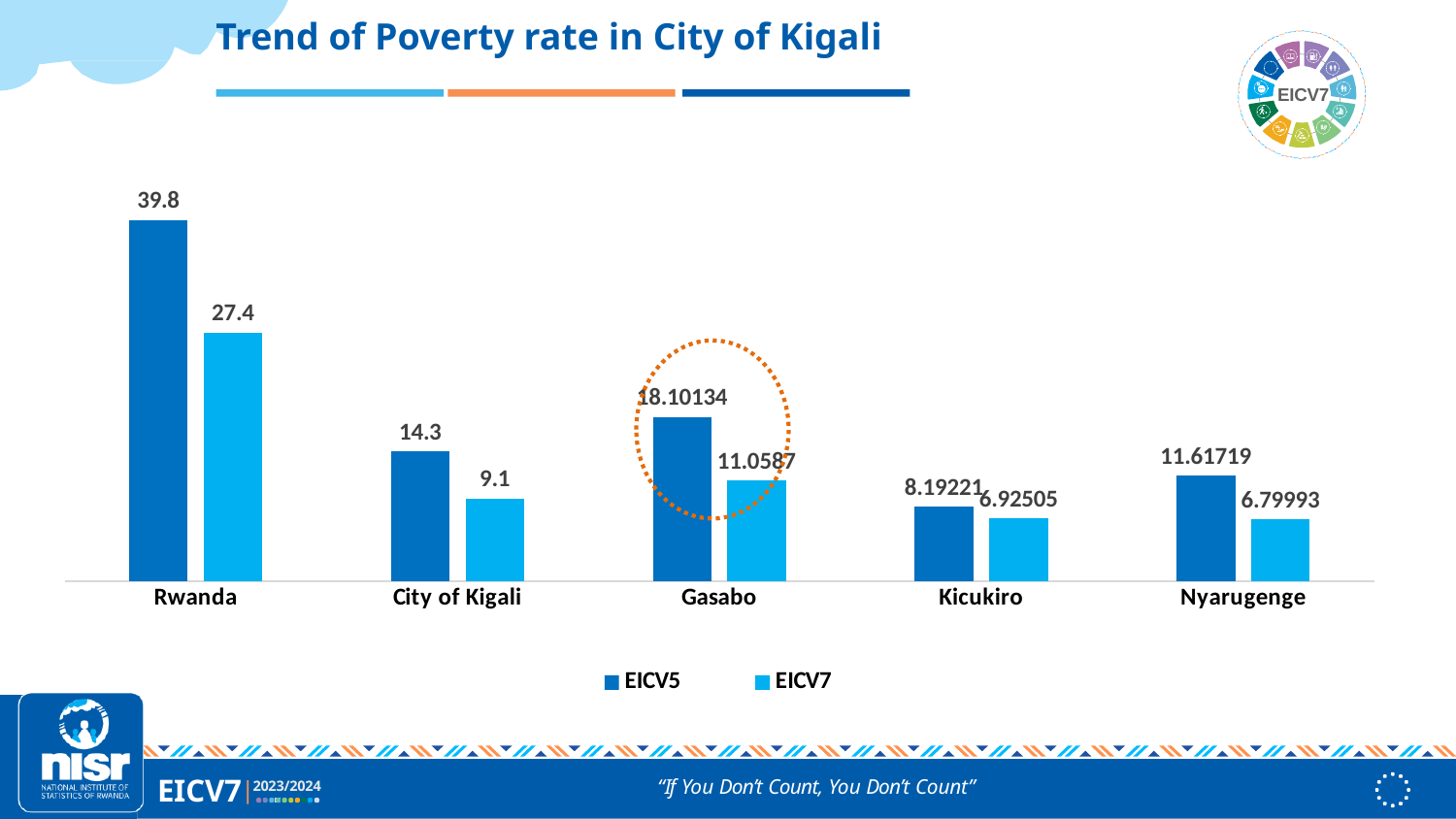
What is the EICV7 poverty rate for City of Kigali? 9.1 Which is larger, the EICV5 value for Gasabo or the EICV5 value for Nyarugenge? Gasabo Which category has the lowest EICV5 value? Kicukiro How many series does the legend list? 2 How many categories are shown on the x axis? 5 What is the EICV5 value for Gasabo? 18.10134 What kind of chart is shown on the slide? Bar chart What is the difference between the EICV5 and EICV7 values for City of Kigali? 5.2 What is the difference between the EICV5 and EICV7 values for Rwanda? 12.4 Which category has the highest EICV7 value? Rwanda What is the EICV7 value for Nyarugenge? 6.79993 What is the EICV5 poverty rate for Rwanda? 39.8